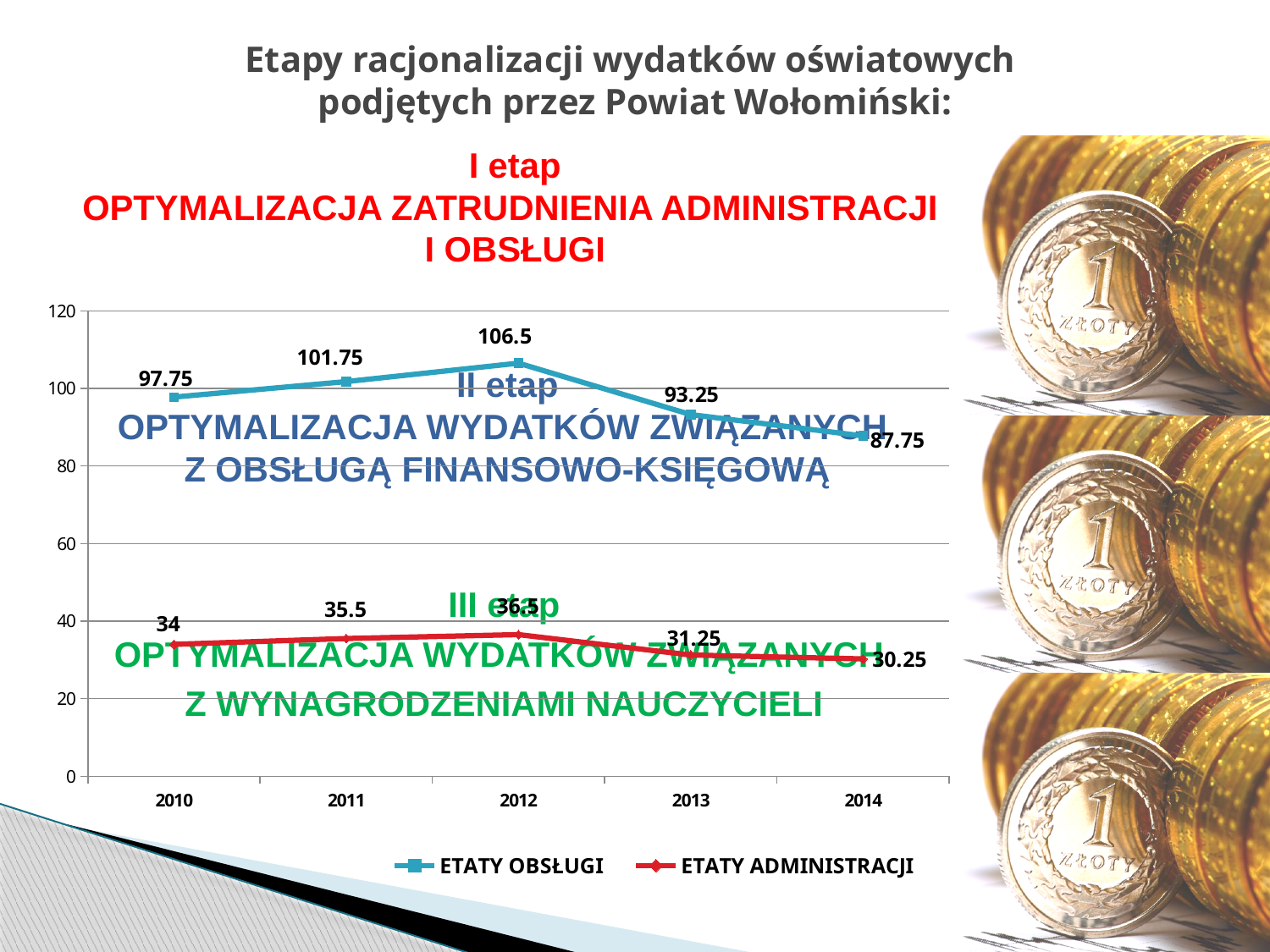
How many years are shown on the x axis of the chart? 5 What is the value of ETATY ADMINISTRACJI in 2010? 34 How many series does the chart legend list? 2 What is the difference between ETATY ADMINISTRACJI in 2013 and in 2014? 1 Is the value for ETATY OBSŁUGI in 2013 greater or less than 80? greater In which year is ETATY OBSŁUGI highest? 2012 What kind of chart is shown on the slide? line chart What is the difference between ETATY OBSŁUGI in 2010 and in 2014? 10 What is the value of ETATY OBSŁUGI in 2012? 106.5 In which year is ETATY OBSŁUGI lowest? 2014 Which year has the larger value for ETATY OBSŁUGI, 2011 or 2013? 2011 What is the value of ETATY ADMINISTRACJI in 2014? 30.25